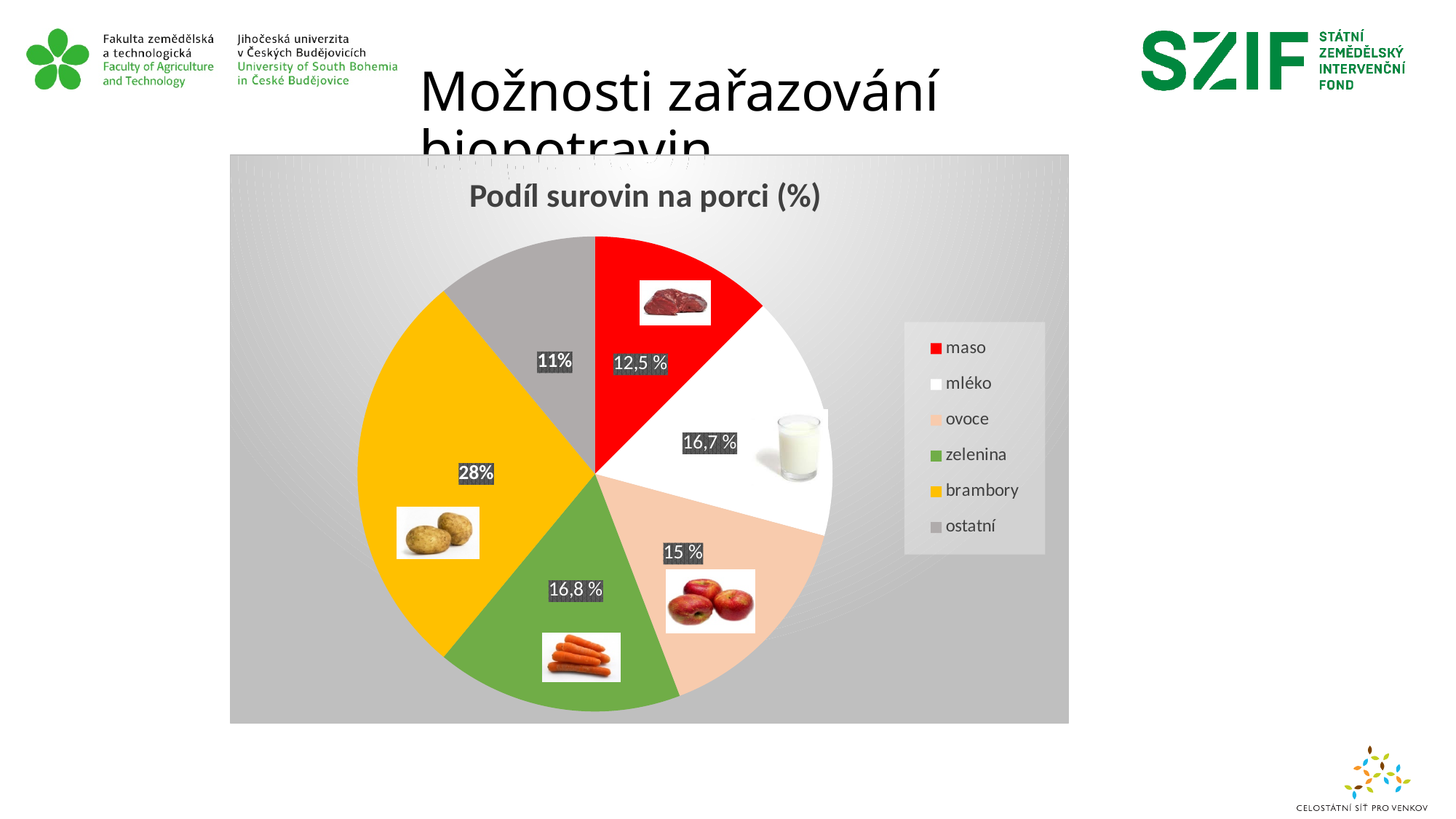
What is the difference between the share for brambory and the share for ostatní? 17 percentage points What is the title of the chart? Podíl surovin na porci (%) Which category has the smallest share of the pie? ostatní What is the value shown for zelenina? 16,8 % What kind of chart is shown on the slide? pie chart What is the value shown for brambory? 28% How many series does the legend list? 6 What is the value shown for ovoce? 15 % What is the value shown for maso? 12,5 % Which category has the largest share of the pie? brambory What is the value shown for mléko? 16,7 % Which is larger, the share for maso or the share for ovoce? ovoce